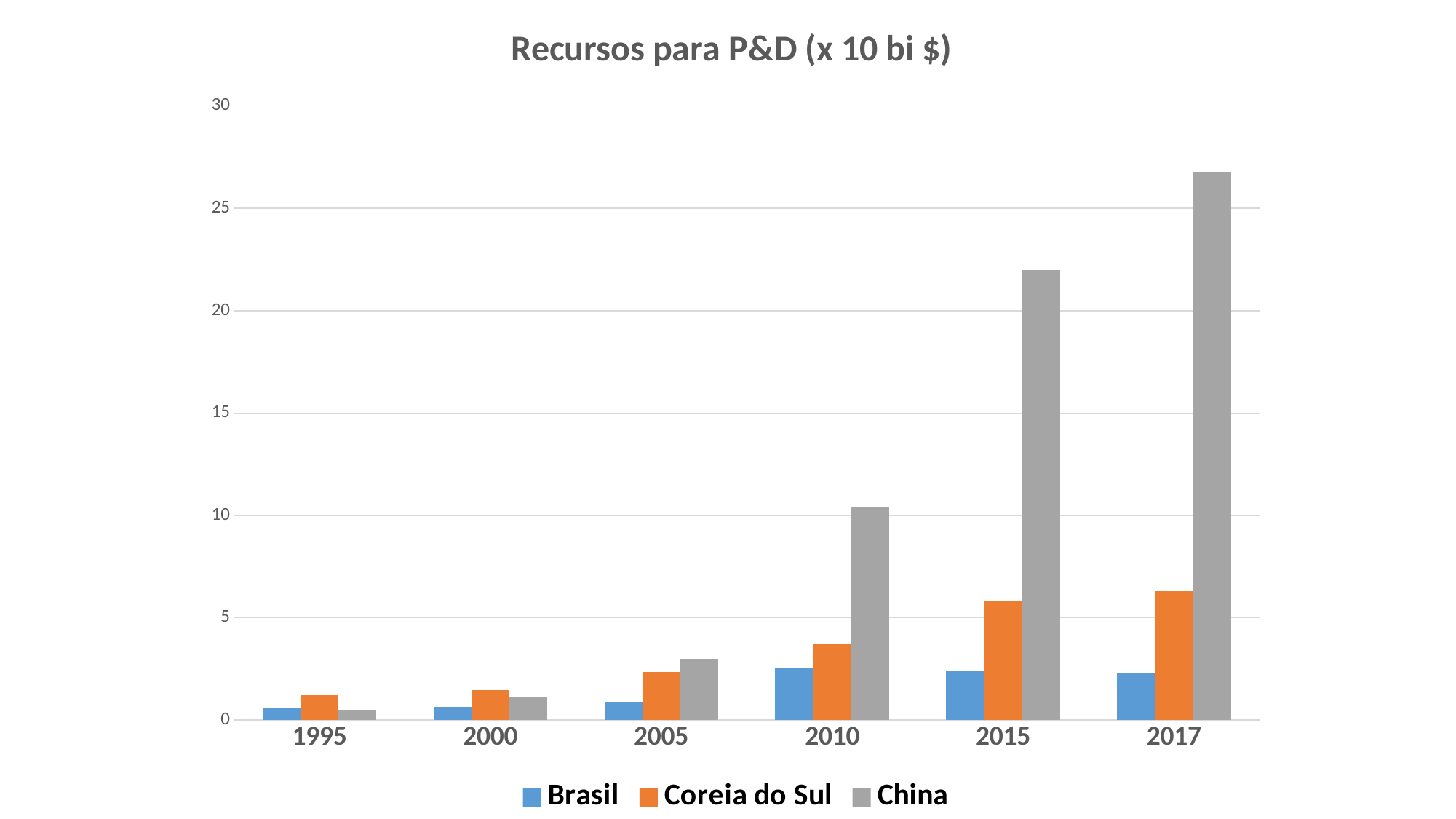
How many series does the legend list? 3 Is the value for China in 2015 greater or less than 20? greater Is the value for Coreia do Sul in 2017 greater or less than 10? less Do the values for China rise or fall from 1995 to 2017? rise In which year is the value for China lowest? 1995 What kind of chart is shown on the slide? bar chart Is the value for China in 2017 greater or less than 25? greater In 1995, which is larger: the value for Brasil or the value for Coreia do Sul? Coreia do Sul In which year is the value for China highest? 2017 In 2010, which is larger: the value for China or the value for Coreia do Sul? China How many years are shown on the x axis? 6 What is the title of the chart? Recursos para P&D (x 10 bi $)